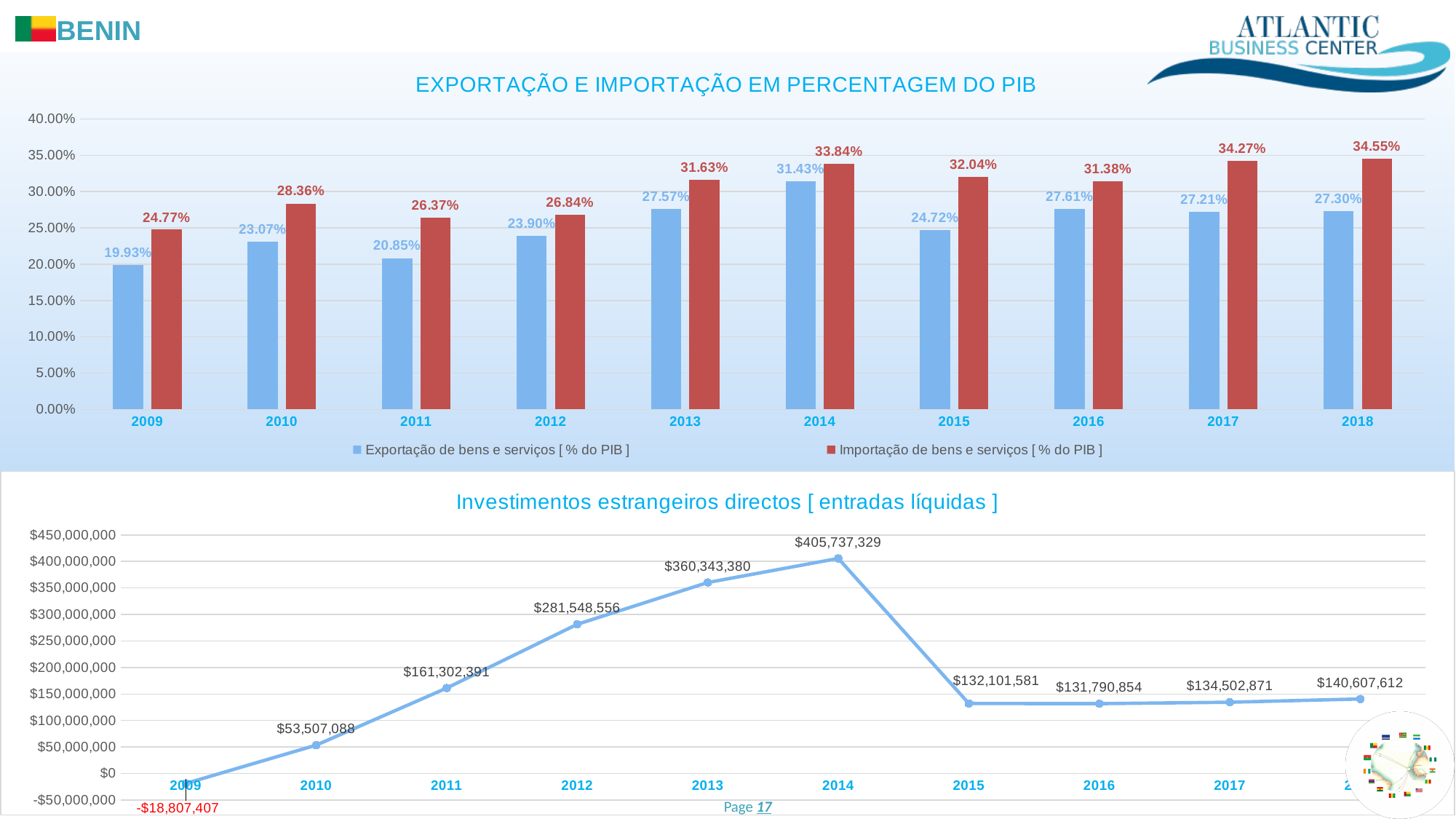
In the chart 'EXPORTAÇÃO E IMPORTAÇÃO EM PERCENTAGEM DO PIB', what is the difference between Importação and Exportação in 2018? 7.25% In the chart 'Investimentos estrangeiros directos [ entradas líquidas ]', which year has the lowest value? 2009 In the chart 'EXPORTAÇÃO E IMPORTAÇÃO EM PERCENTAGEM DO PIB', what is the value of Importação de bens e serviços [ % do PIB ] for 2011? 26.37% In the chart 'Investimentos estrangeiros directos [ entradas líquidas ]', do the values rise or fall from 2009 to 2014? Rise In the chart 'EXPORTAÇÃO E IMPORTAÇÃO EM PERCENTAGEM DO PIB', how many series does the legend list? 2 In the chart 'EXPORTAÇÃO E IMPORTAÇÃO EM PERCENTAGEM DO PIB', how many years are shown on the x axis? 10 What kind of chart is 'Investimentos estrangeiros directos [ entradas líquidas ]'? Line chart In the chart 'EXPORTAÇÃO E IMPORTAÇÃO EM PERCENTAGEM DO PIB', which year has the highest Importação de bens e serviços value? 2018 In the chart 'EXPORTAÇÃO E IMPORTAÇÃO EM PERCENTAGEM DO PIB', which year has the lowest Exportação de bens e serviços value? 2009 In the chart 'Investimentos estrangeiros directos [ entradas líquidas ]', what is the value for 2014? $405,737,329 In the chart 'EXPORTAÇÃO E IMPORTAÇÃO EM PERCENTAGEM DO PIB', what is the value of Exportação de bens e serviços [ % do PIB ] for 2014? 31.43% In the chart 'Investimentos estrangeiros directos [ entradas líquidas ]', is the value for 2015 larger or smaller than the value for 2016? Larger